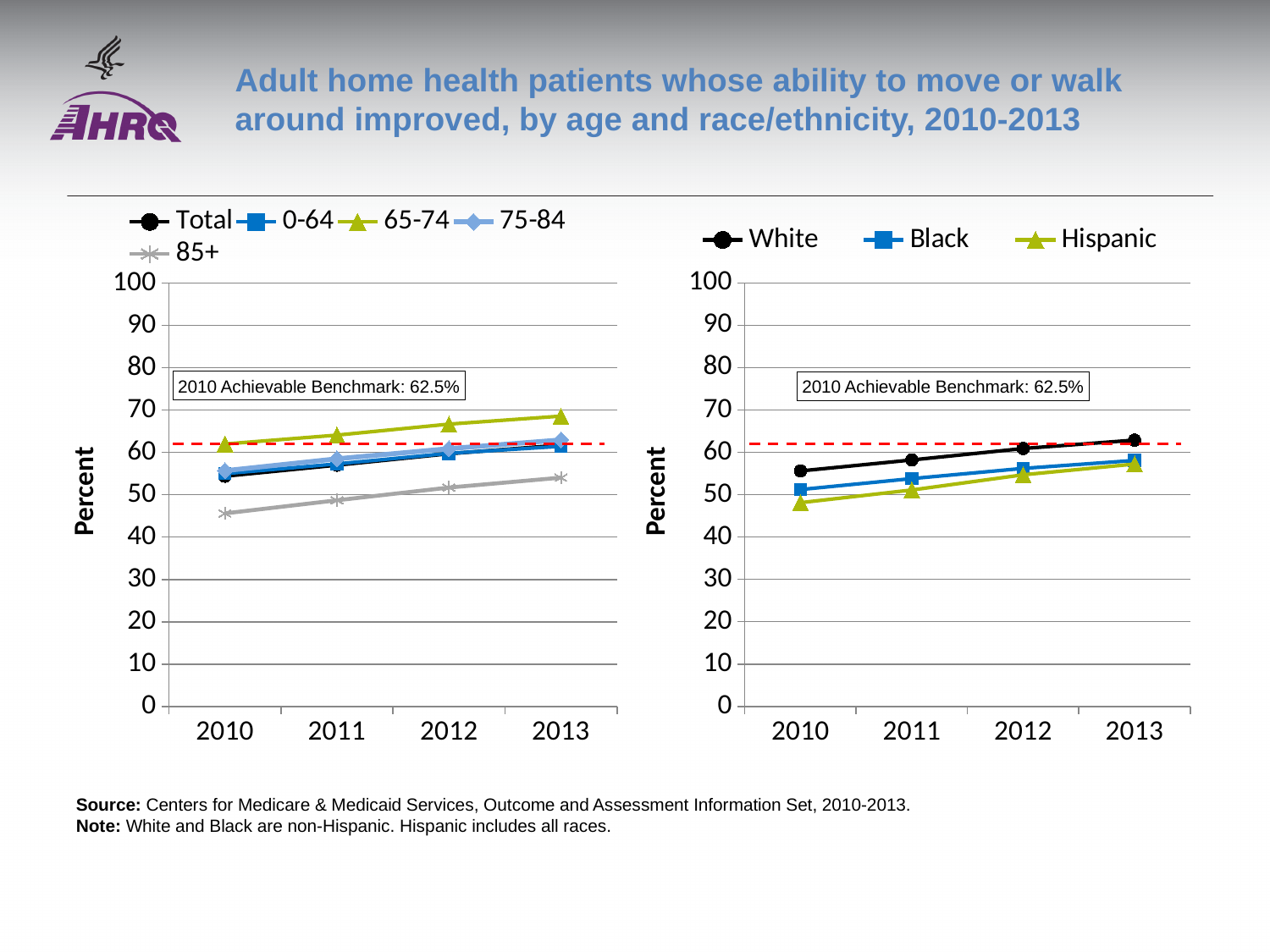
What type of chart is the left chart (by age)? line chart In the right chart (by race/ethnicity), is the value for Hispanic in 2010 greater or less than 50? less In the left chart (by age), which age group has the lowest value in 2010? 85+ How many series does the legend of the left chart (by age) list? 5 In the right chart (by race/ethnicity), does the value for Black rise or fall from 2010 to 2013? rise In the left chart (by age), is the value for 85+ in 2010 greater or less than 50? less In the left chart (by age), is the value for 65-74 in 2013 greater or less than 60? greater How many years are shown on the x axis of the right chart (by race/ethnicity)? 4 In the right chart (by race/ethnicity), which group has the highest value in 2010? White In the left chart (by age), which age group has the highest value in 2013? 65-74 What is the 2010 Achievable Benchmark shown on the charts? 62.5% How many series does the legend of the right chart (by race/ethnicity) list? 3